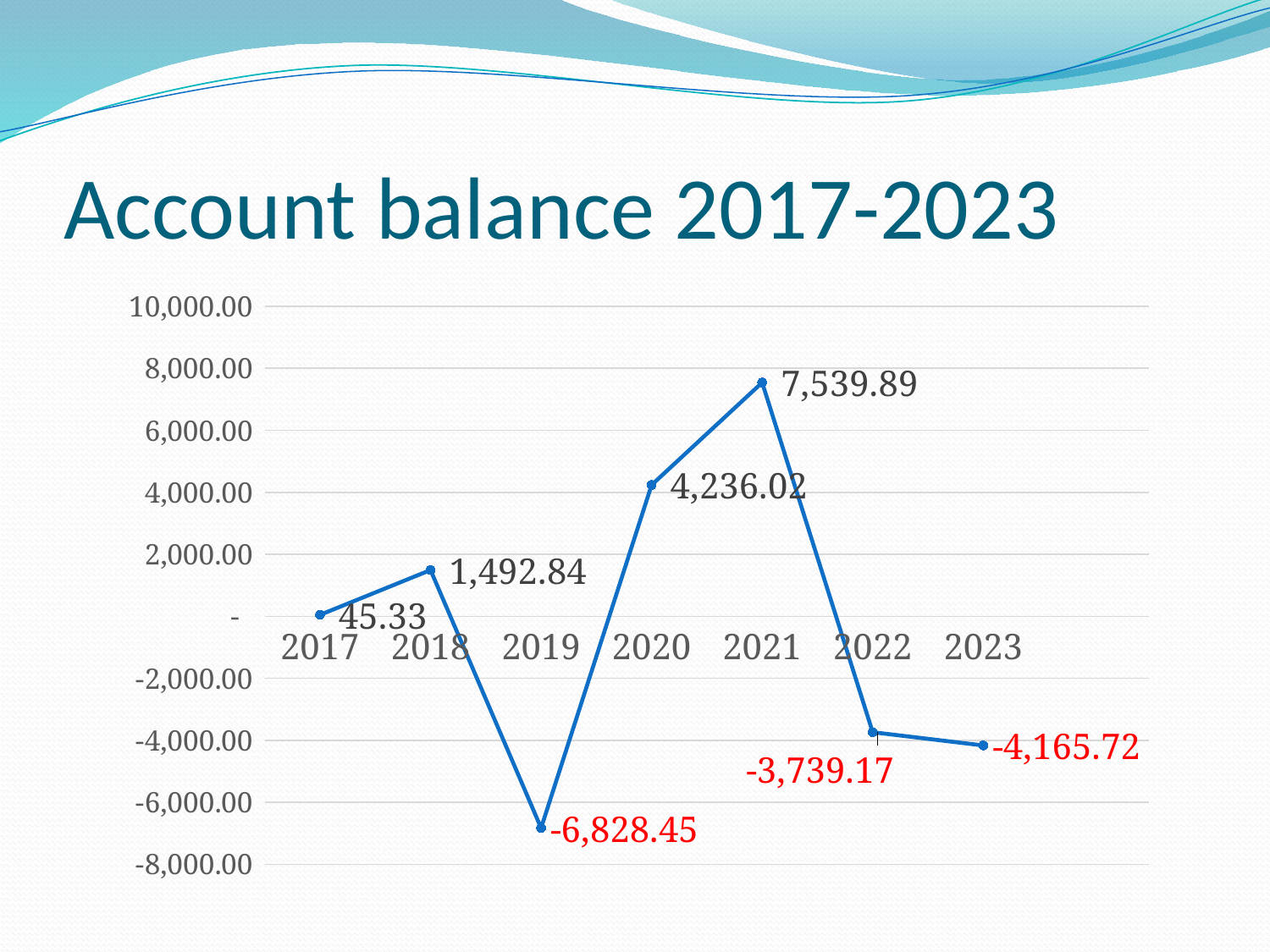
Which year has the larger value, 2018 or 2020? 2020 Which year has the lowest account balance? 2019 What is the difference between the values for 2018 and 2017? 1,447.51 Does the account balance rise or fall from 2021 to 2023? fall How many years are plotted on the chart? 7 What type of chart is shown on the slide? line chart What is the account balance value for 2021? 7,539.89 What is the difference between the values for 2021 and 2020? 3,303.87 What is the account balance value for 2017? 45.33 What is the title of the chart? Account balance 2017-2023 Which year has the highest account balance? 2021 What is the account balance value for 2019? -6,828.45